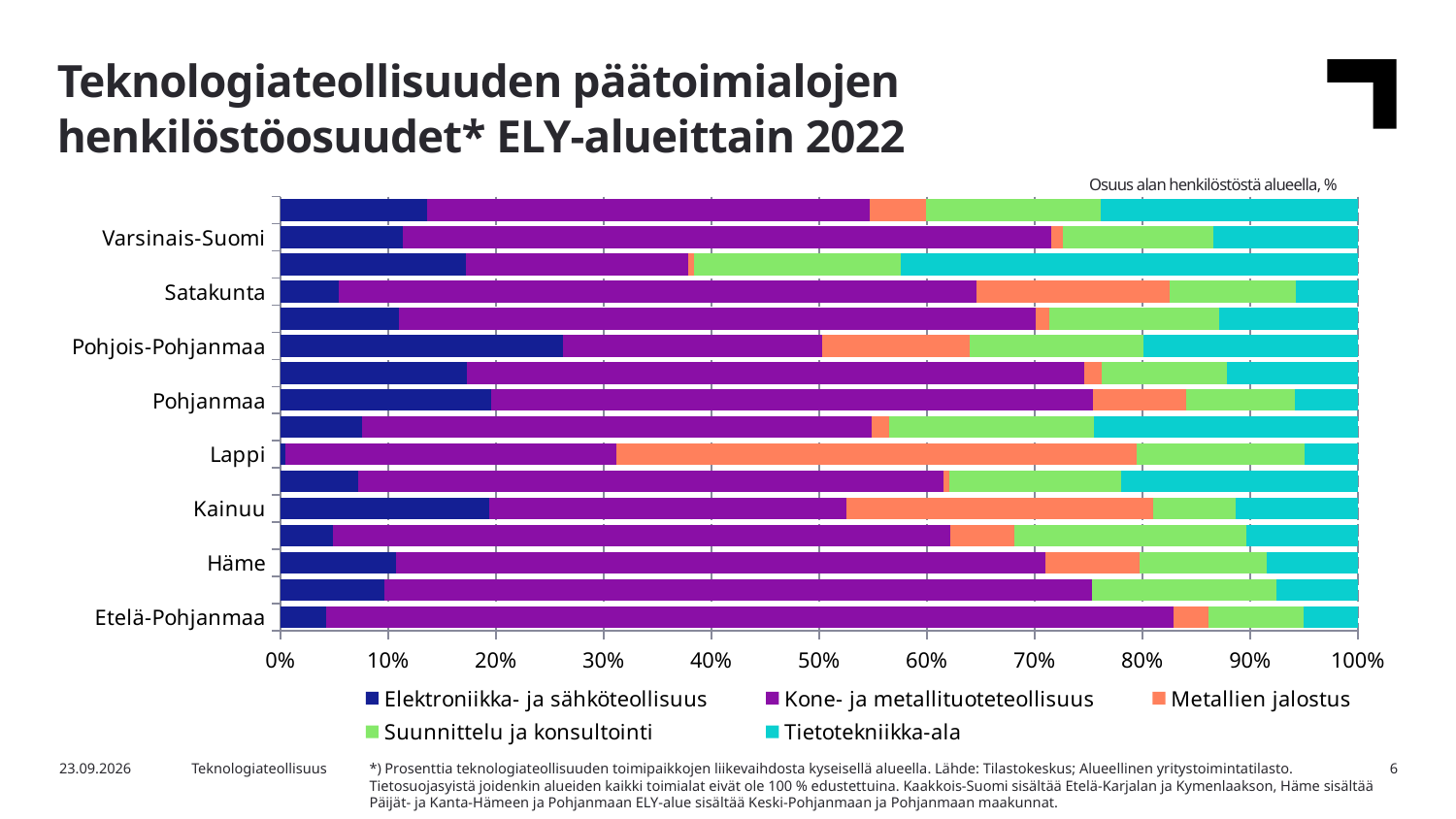
Is the value for Elektroniikka- ja sähköteollisuus in Etelä-Pohjanmaa greater or less than 10%? less Is the value for Elektroniikka- ja sähköteollisuus in Pohjois-Pohjanmaa greater or less than 20%? greater What kind of chart is shown on the slide? Stacked bar chart Which region has the largest share for Metallien jalostus? Lappi Is the value for Metallien jalostus in Lappi greater or less than 40%? greater Which is larger: the Elektroniikka- ja sähköteollisuus share in Pohjois-Pohjanmaa or in Etelä-Pohjanmaa? Pohjois-Pohjanmaa How many series does the legend list? 5 What unit note is shown above the chart? Osuus alan henkilöstöstä alueella, %